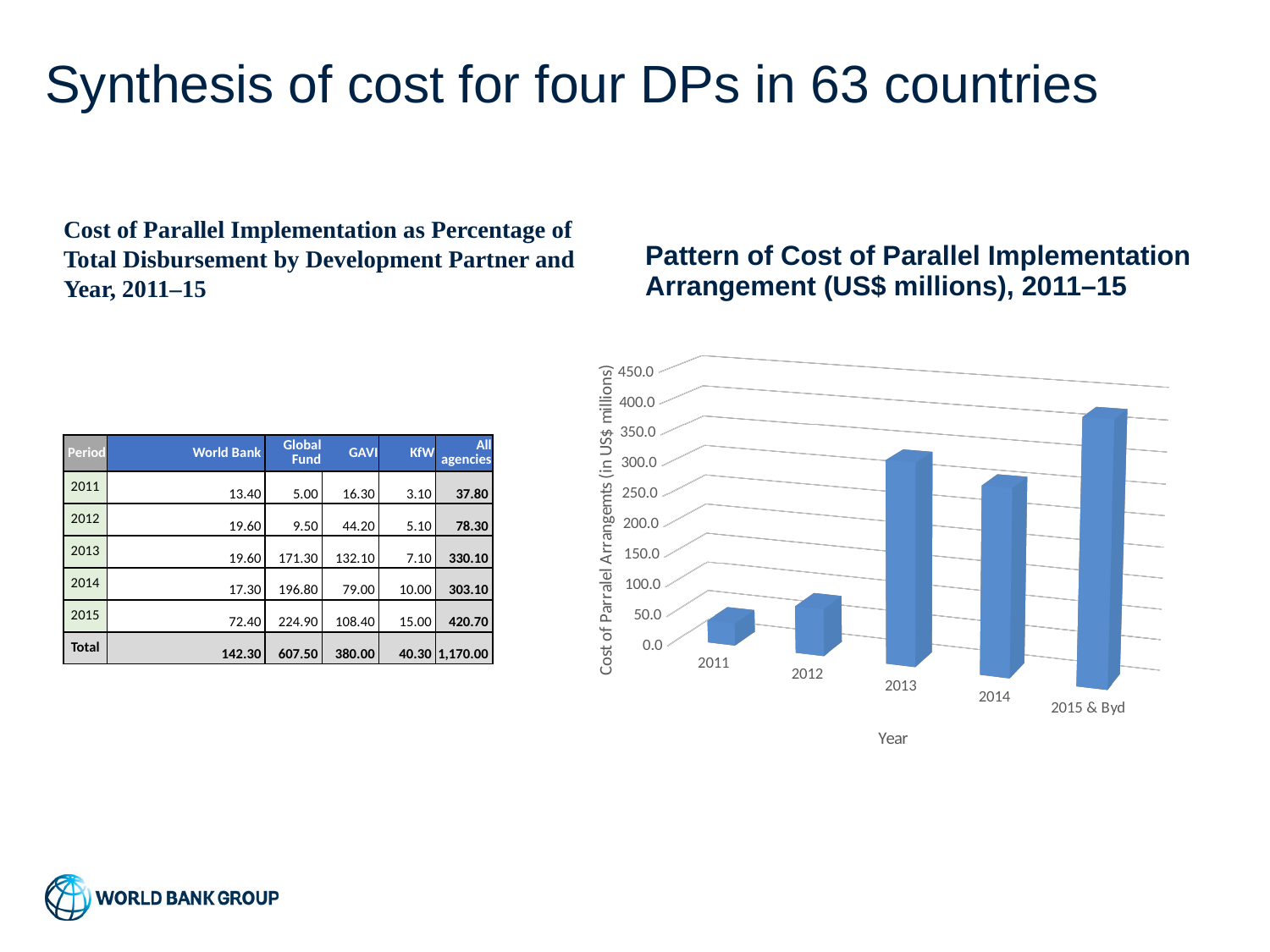
Which year has the tallest bar in the chart? 2015 & Byd What kind of chart is shown on the slide? bar chart Which bar is taller, 2012 or 2013? 2013 Which year has the shortest bar in the chart? 2011 Is the value for 2013 greater or less than 250? greater What is the title of the chart? Pattern of Cost of Parallel Implementation Arrangement (US$ millions), 2011–15 Is the value for 2015 & Byd greater or less than 350? greater Which bar is taller, 2013 or 2014? 2013 Is the value for 2012 greater or less than 50? greater How many bars (years) are plotted in the chart? 5 What is the title of the chart's x axis? Year